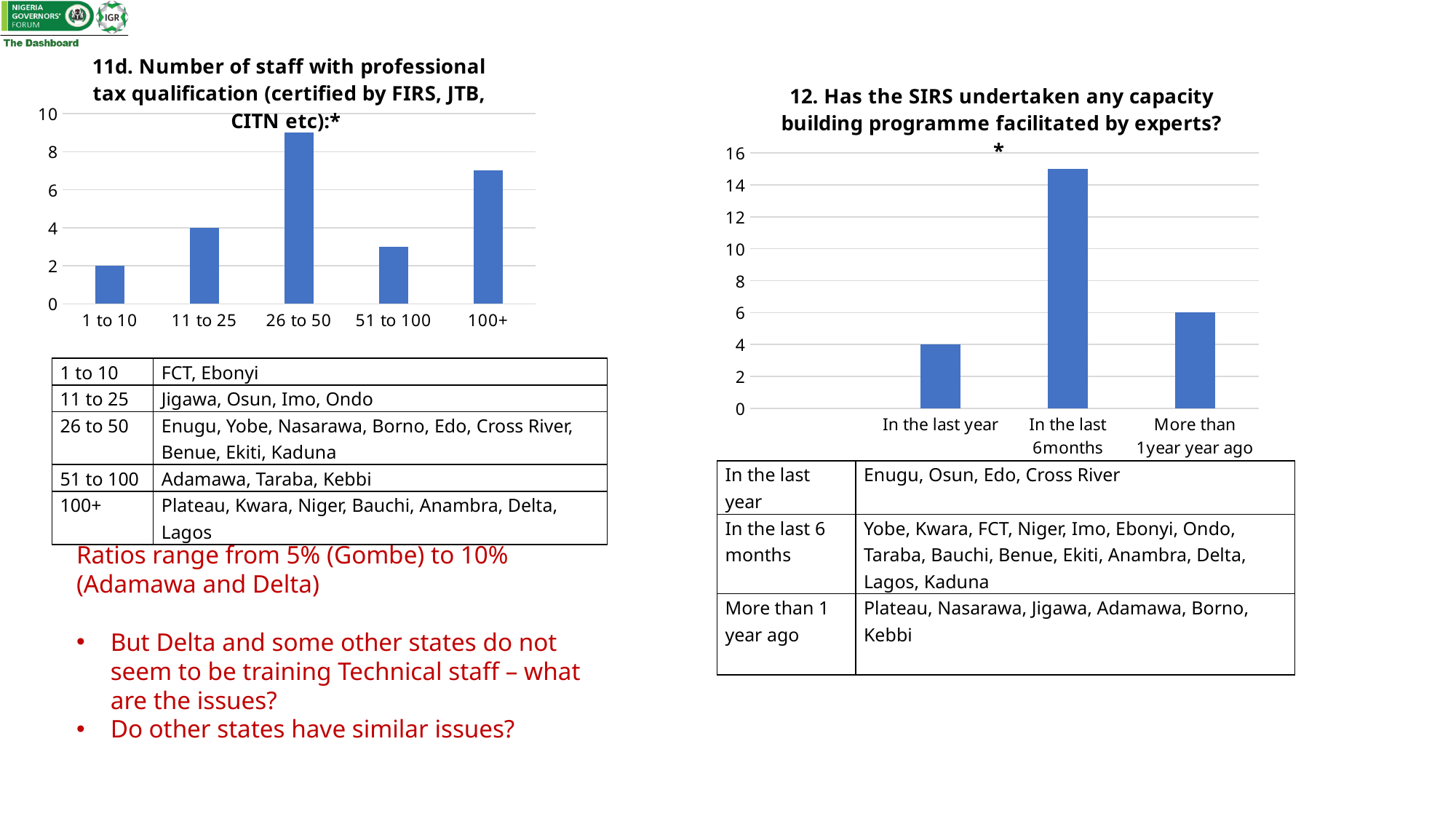
On the chart '11d. Number of staff with professional tax qualification', which category has the lowest bar? 1 to 10 On the chart '11d. Number of staff with professional tax qualification', how many categories are shown on the x axis? 5 On the chart '11d. Number of staff with professional tax qualification', which category has the highest bar? 26 to 50 On the chart '12. Has the SIRS undertaken any capacity building programme facilitated by experts?', what is the value for 'In the last year'? 4 On the chart '12. Has the SIRS undertaken any capacity building programme facilitated by experts?', what is the difference between the values for 'More than 1year year ago' and 'In the last year'? 2 On the chart '12. Has the SIRS undertaken any capacity building programme facilitated by experts?', which category has the highest bar? In the last 6months On the chart '11d. Number of staff with professional tax qualification', what is the value for the '1 to 10' category? 2 On the chart '12. Has the SIRS undertaken any capacity building programme facilitated by experts?', what is the value for 'More than 1year year ago'? 6 What kind of chart is the chart on the right of the slide? bar chart On the chart '11d. Number of staff with professional tax qualification', what is the value for the '11 to 25' category? 4 On the chart '11d. Number of staff with professional tax qualification', is the value for '51 to 100' greater or less than 4? less On the chart '11d. Number of staff with professional tax qualification', is the value for '26 to 50' greater or less than 8? greater